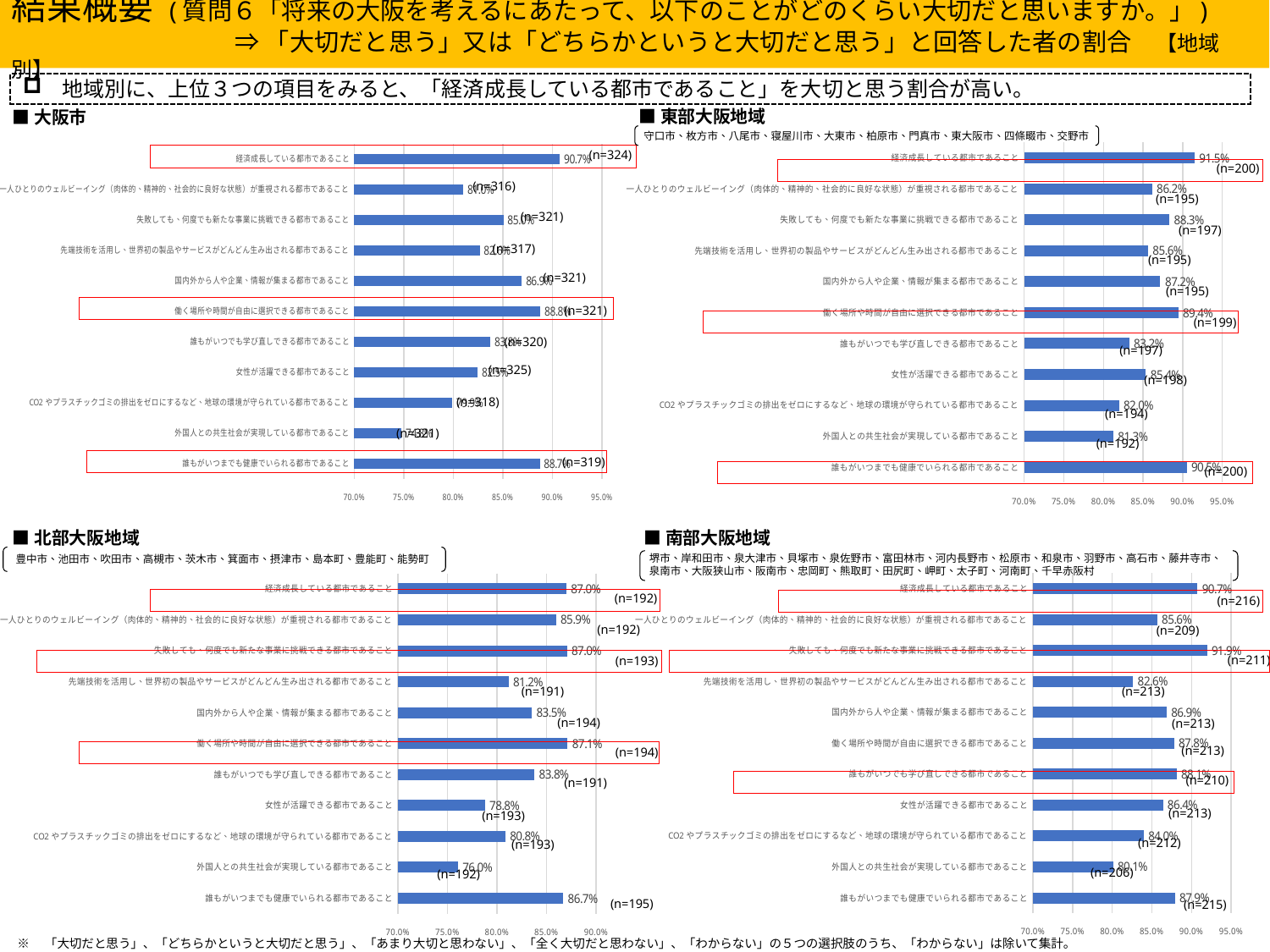
In the 東部大阪地域 chart, which item has the lowest value? 外国人との共生社会が実現している都市であること What kind of chart is the 東部大阪地域 chart? Bar chart In the 北部大阪地域 chart, which item has the lowest value? 外国人との共生社会が実現している都市であること In the 南部大阪地域 chart, what is the value for 失敗しても、何度でも新たな事業に挑戦できる都市であること? 91.9% In the 南部大阪地域 chart, which item has the highest value? 失敗しても、何度でも新たな事業に挑戦できる都市であること In the 東部大阪地域 chart, what is the difference between 経済成長している都市であること and 誰もがいつまでも健康でいられる都市であること? 1.0 percentage points In the 南部大阪地域 chart, which is larger: 国内外から人や企業、情報が集まる都市であること or 女性が活躍できる都市であること? 国内外から人や企業、情報が集まる都市であること In the 北部大阪地域 chart, what is the value for 女性が活躍できる都市であること? 78.8% How many items are plotted in the 北部大阪地域 chart? 11 In the 大阪市 chart, is the value for 外国人との共生社会が実現している都市であること greater or less than 80.0%? less In the 東部大阪地域 chart, what is the value for 経済成長している都市であること? 91.5% In the 大阪市 chart, what is the value for 働く場所や時間が自由に選択できる都市であること? 88.8%